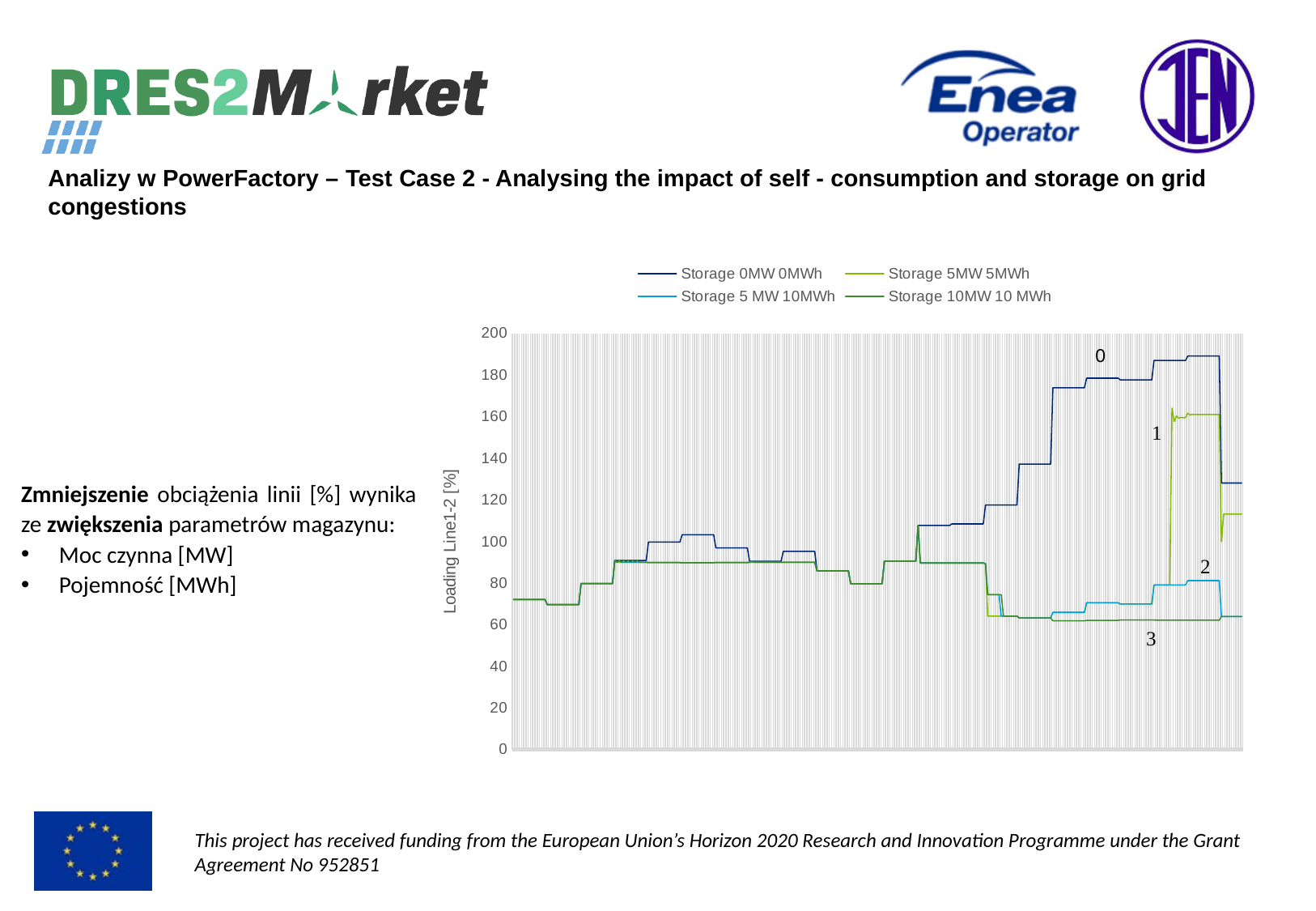
What kind of chart is shown on the slide? line chart Is the peak value of the Storage 5 MW 10MWh series greater or less than 100? less How many series does the chart legend list? 4 What is the label of the vertical axis of the chart? Loading Line1-2 [%] Which series is listed first in the chart legend? Storage 0MW 0MWh What is the highest value shown on the vertical axis of the chart? 200 Is the peak value of the Storage 0MW 0MWh series greater or less than 180? greater Is the peak value of the Storage 5MW 5MWh series greater or less than 140? greater Which series is higher in the right part of the chart, Storage 5MW 5MWh or Storage 5 MW 10MWh? Storage 5MW 5MWh Which series reaches the highest loading value on the chart? Storage 0MW 0MWh